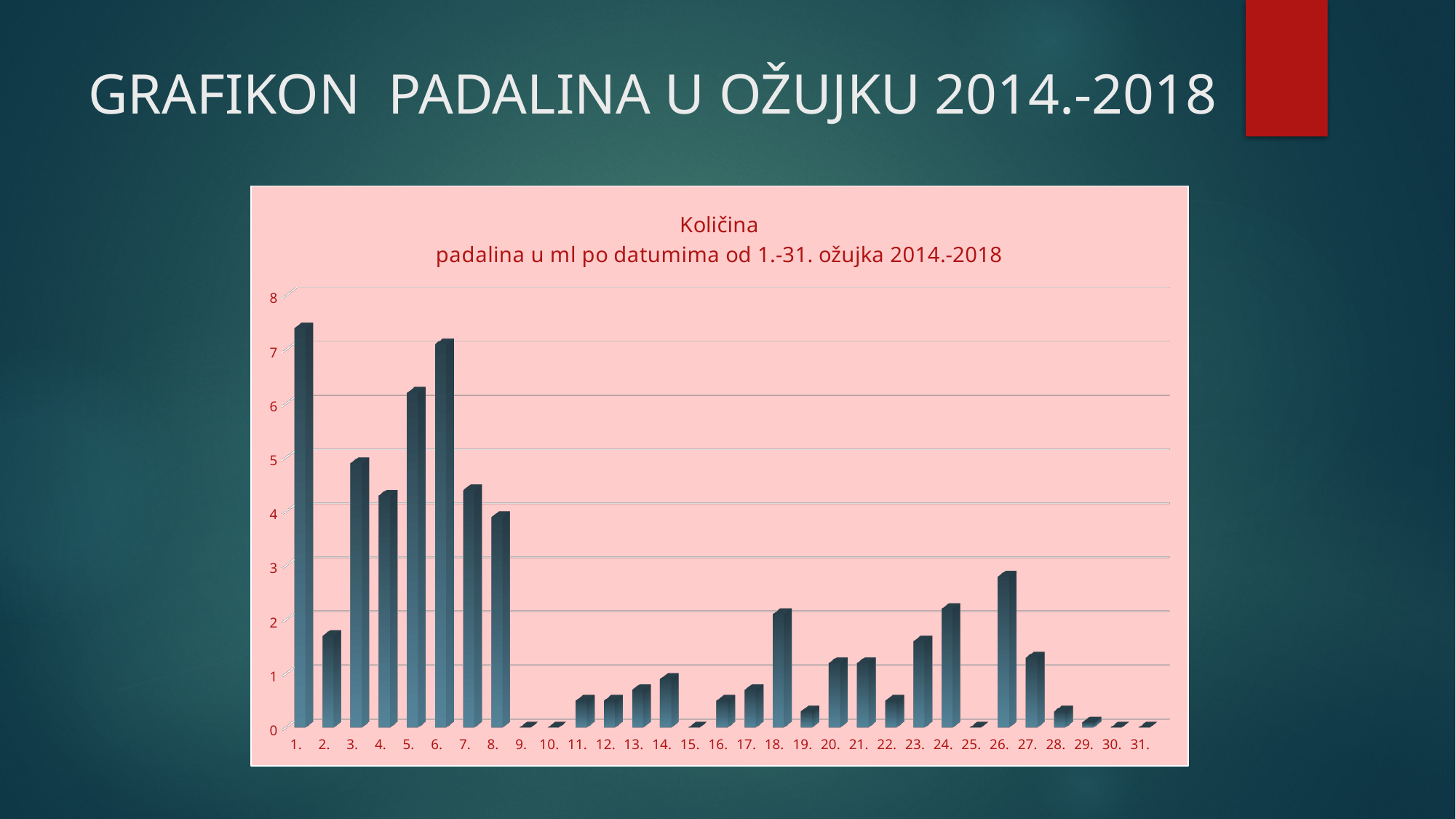
Which date has the highest amount of precipitation in the chart? 1. Is the value for date 5. greater or less than 6? greater Which has the larger value, date 3. or date 4.? 3. Which has the larger value, date 26. or date 24.? 26. What is the title of the chart? Količina padalina u ml po datumima od 1.-31. ožujka 2014.-2018 What kind of chart is shown on the slide? bar chart How many dates (categories) are plotted on the x axis of the chart? 31 Is the value for date 1. greater or less than 7? greater What is the highest value shown on the vertical axis of the chart? 8